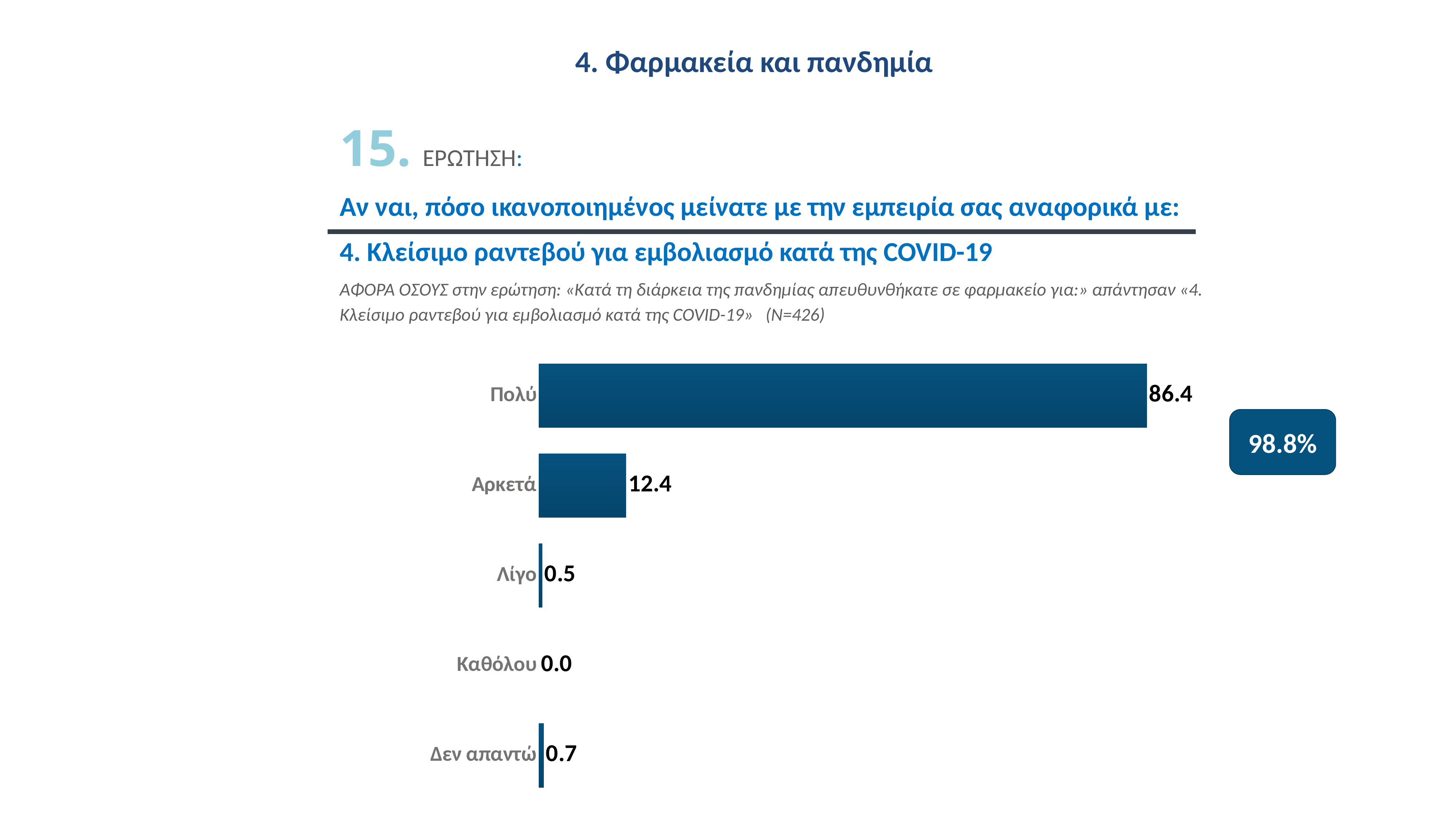
What is the difference between the values for Πολύ and Αρκετά? 74.0 What is the value for Δεν απαντώ? 0.7 Which category has the lowest value? Καθόλου What is the value for Πολύ? 86.4 Which is larger, the value for Λίγο or the value for Δεν απαντώ? Δεν απαντώ Which category has the highest value? Πολύ What is the value for Αρκετά? 12.4 What kind of chart is shown on the slide? Bar chart What percentage is shown in the highlighted box to the right of the chart? 98.8% What is the value for Καθόλου? 0.0 How many categories are shown in the chart? 5 What is the value for Λίγο? 0.5